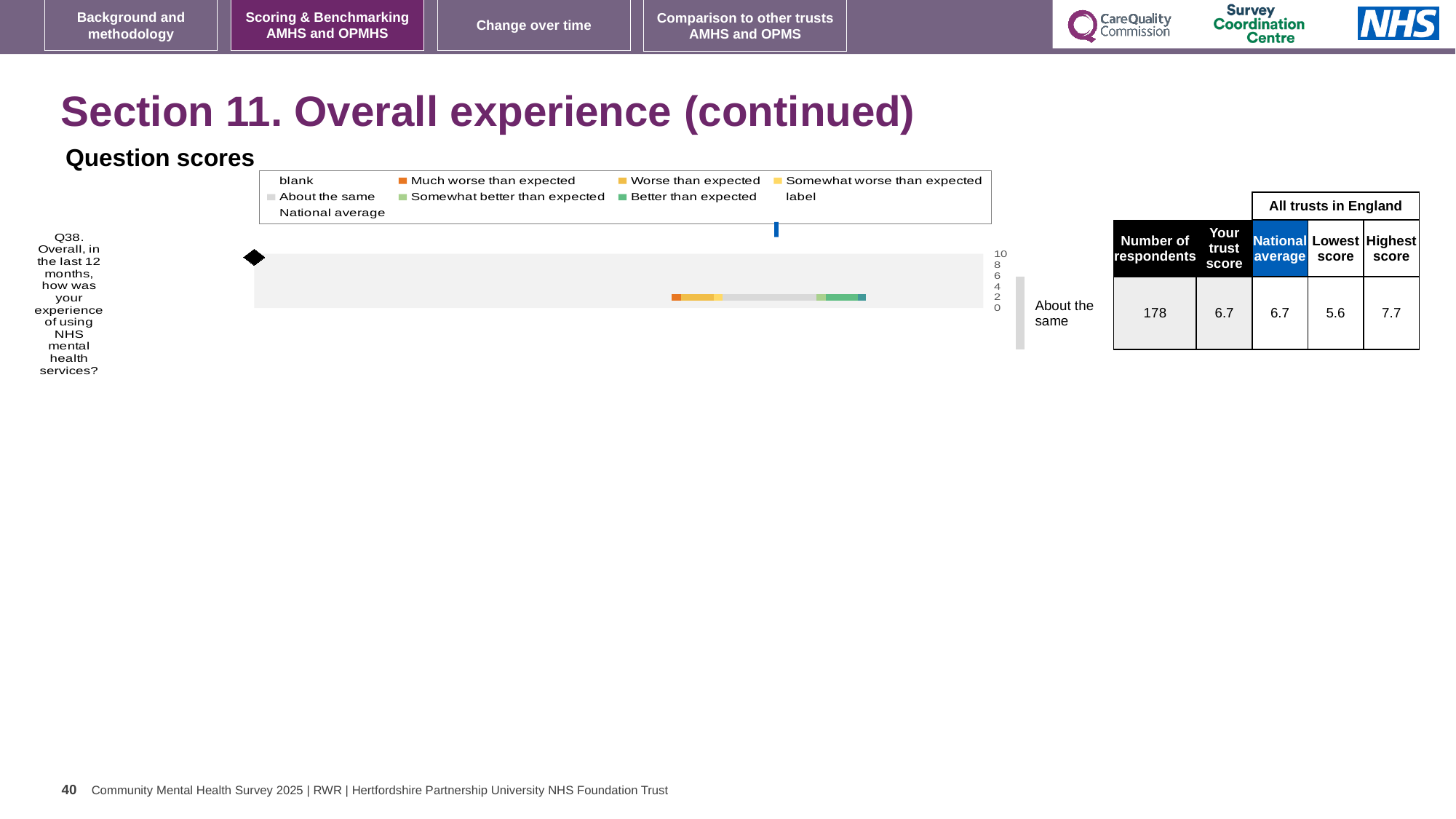
What is the lowest score among all trusts in England for Q38? 5.6 What kind of chart is shown under 'Question scores'? bar chart What is the difference between the highest and lowest trust scores for Q38? 2.1 What is the national average score for Q38? 6.7 What colour does the legend use for 'Much worse than expected'? orange How many survey questions are plotted in the chart? 1 What is the highest score among all trusts in England for Q38? 7.7 What is the trust's score for Q38? 6.7 Is the trust's score for Q38 higher than, lower than, or the same as the national average? the same What benchmark label is shown to the right of the Q38 bar? About the same How many respondents answered Q38? 178 Is the trust's score for Q38 greater or less than 6? greater